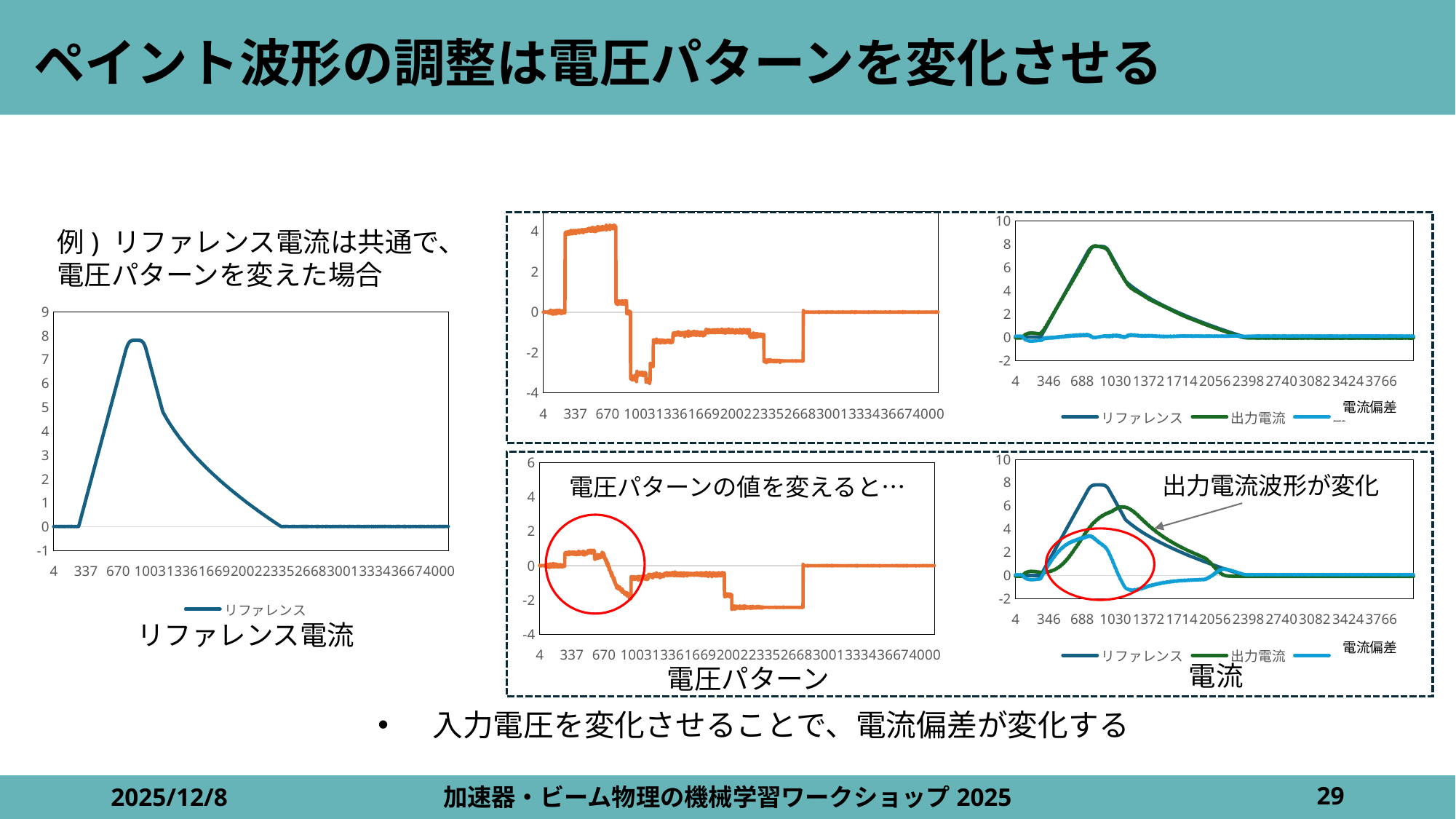
In the left 'リファレンス電流' chart, after the peak, do the values rise or fall as x increases? fall What kind of chart is the 'リファレンス電流' chart on the left of the slide? line chart In the top-middle voltage pattern chart, is the value of the first plateau (around x = 337 to 670) greater or less than 2? greater In the left 'リファレンス電流' chart, is the peak value of the リファレンス line greater or less than 6? greater In the bottom-right '電流' chart, is the peak of the 出力電流 line greater or less than 8? less In the bottom-right '電流' chart, what colour is the 出力電流 line? green In the bottom-right '電流' chart, how many series does the legend list? 3 In the left 'リファレンス電流' chart, what is the only legend entry? リファレンス In the bottom-right '電流' chart, which series reaches a higher peak, リファレンス or 出力電流? リファレンス